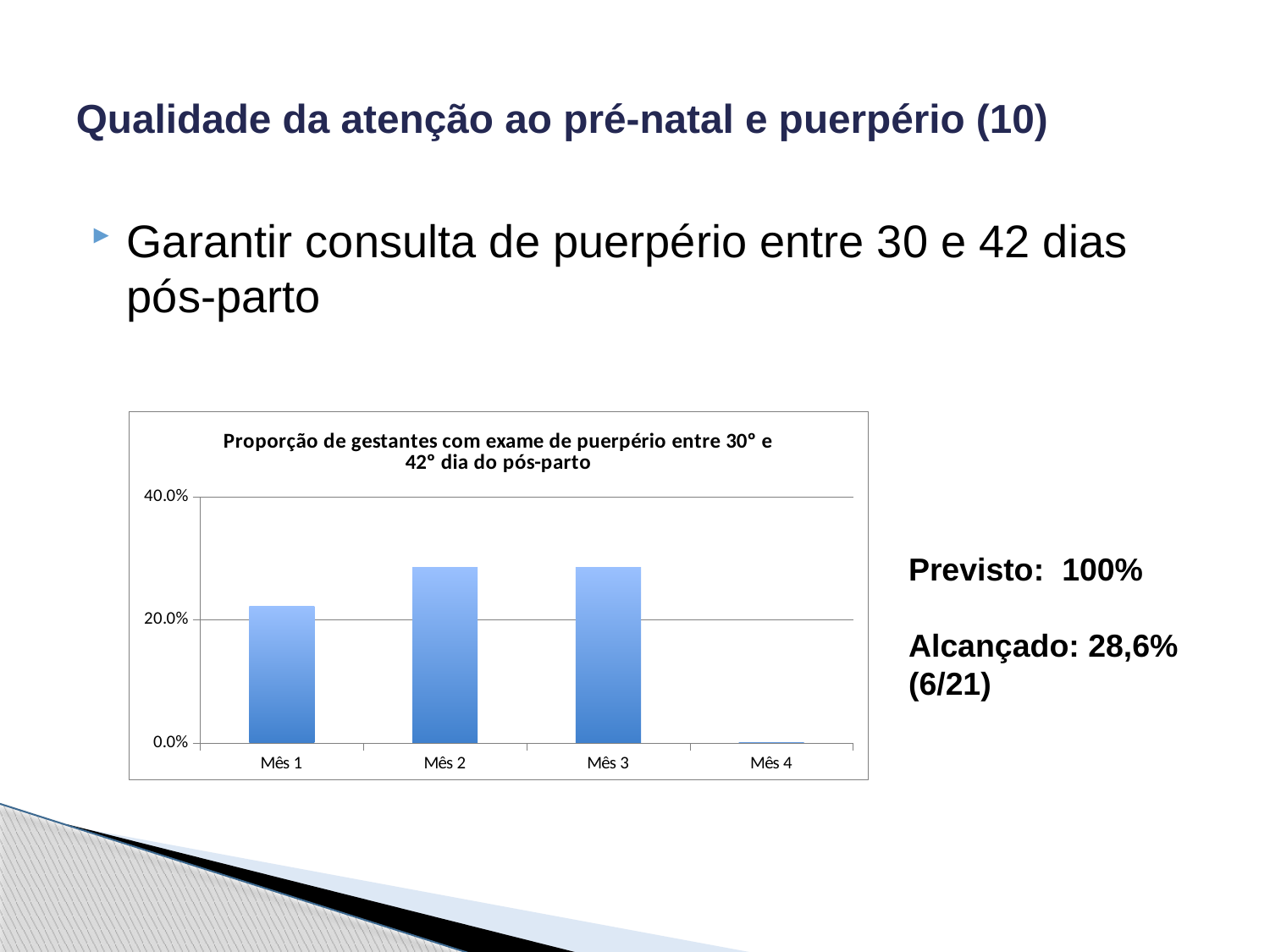
What kind of chart is shown on the slide? bar chart Which is larger, the value for Mês 3 or the value for Mês 4? Mês 3 Is the value for Mês 2 greater or less than 40.0%? less Is the value for Mês 1 greater or less than 20.0%? greater How many categories (months) are shown on the x axis of the chart? 4 Which month has the lowest value in the chart? Mês 4 What is the title of the chart? Proporção de gestantes com exame de puerpério entre 30° e 42° dia do pós-parto Is the value for Mês 3 greater or less than 20.0%? greater What is the highest value shown on the y axis of the chart? 40.0% Does the value rise or fall from Mês 3 to Mês 4? fall Which is larger, the value for Mês 1 or the value for Mês 2? Mês 2